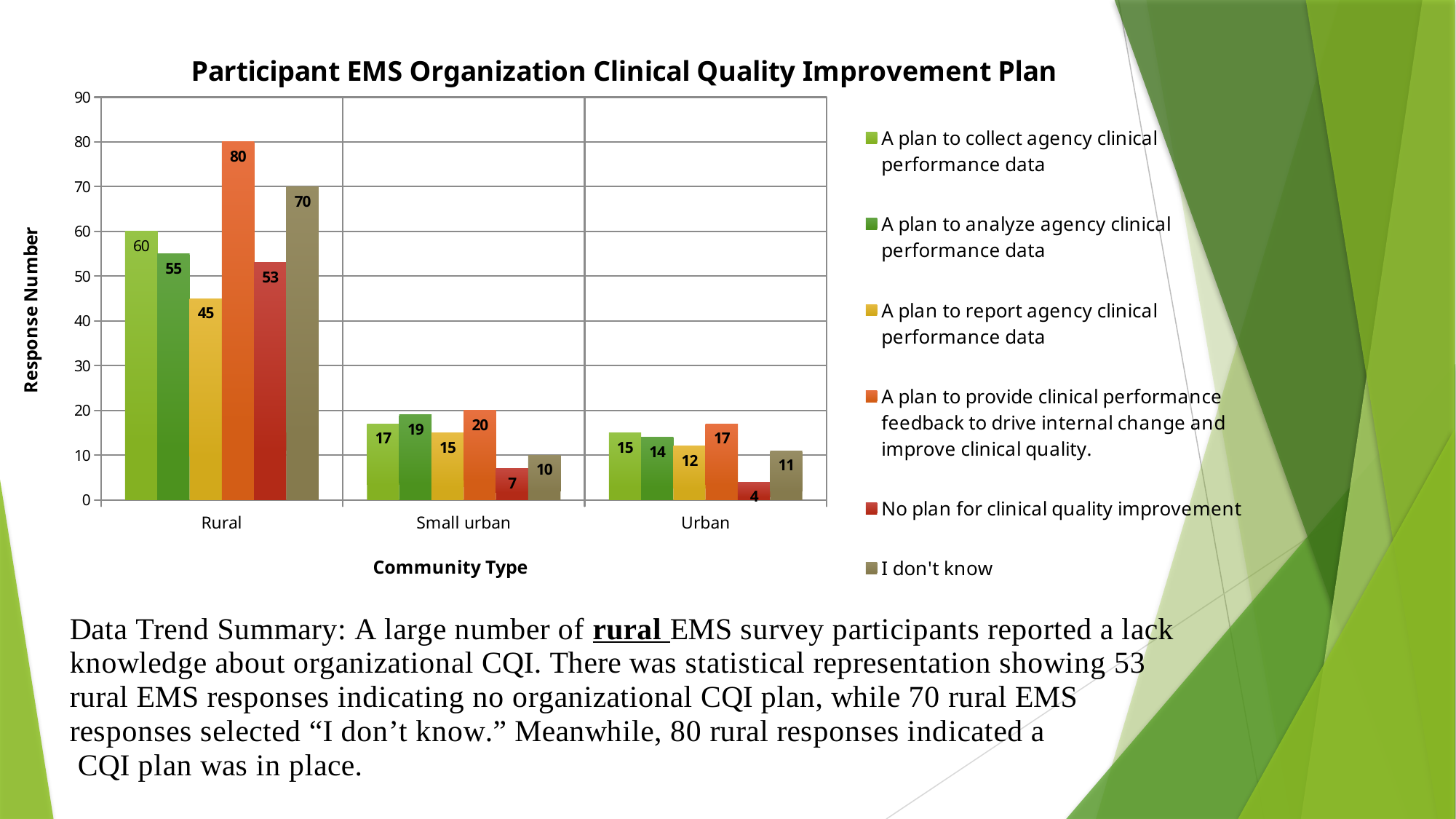
What is the value for "A plan to provide clinical performance feedback to drive internal change and improve clinical quality." in the Rural category? 80 Which series has the highest value in the Rural category? A plan to provide clinical performance feedback to drive internal change and improve clinical quality. Is the value for "A plan to report agency clinical performance data" in the Rural category greater or less than 40? greater Which is larger in the Small urban category: "A plan to collect agency clinical performance data" or "A plan to analyze agency clinical performance data"? A plan to analyze agency clinical performance data How many series does the legend list? 6 How many community type categories are shown on the x axis? 3 What is the value for "I don't know" in the Urban category? 11 What kind of chart is shown on the slide? bar chart What is the value for "No plan for clinical quality improvement" in the Small urban category? 7 What is the difference between the Rural values for "I don't know" and "No plan for clinical quality improvement"? 17 Which series has the lowest value in the Urban category? No plan for clinical quality improvement What is the title of the chart? Participant EMS Organization Clinical Quality Improvement Plan